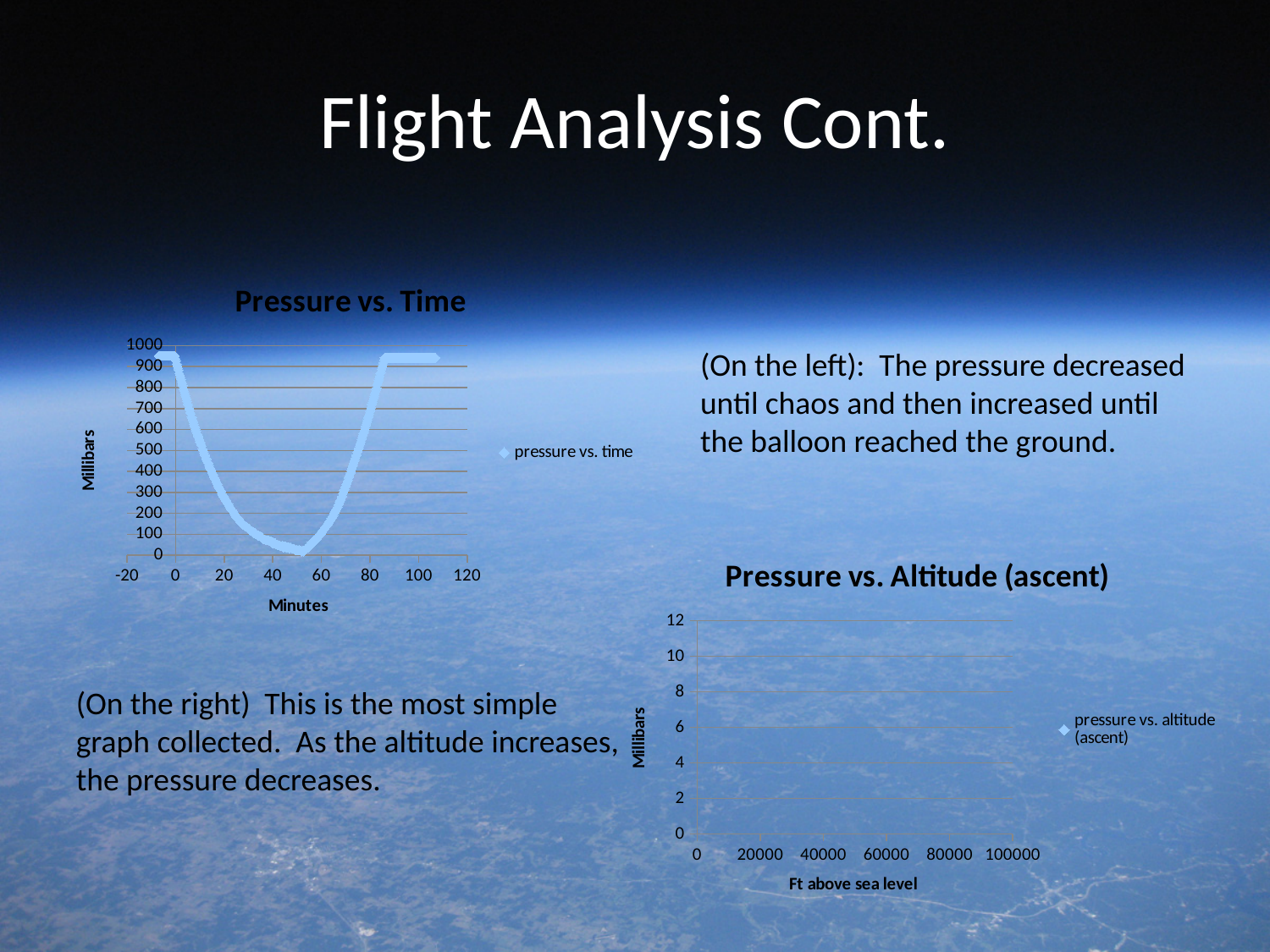
How many series does the legend of the "Pressure vs. Time" chart list? 1 In the "Pressure vs. Time" chart, is the pressure at 60 minutes greater or less than 300? less In the "Pressure vs. Time" chart, is the pressure at 80 minutes greater or less than 600? greater In the "Pressure vs. Time" chart, is the pressure higher at 20 minutes or at 90 minutes? 90 minutes What kind of chart is the "Pressure vs. Time" chart? scatter chart In the "Pressure vs. Time" chart, is the pressure at 100 minutes greater or less than 900? greater What is the x-axis title of the "Pressure vs. Altitude (ascent)" chart? Ft above sea level In the "Pressure vs. Time" chart, how does the pressure change between 0 and 50 minutes? it falls How many series does the legend of the "Pressure vs. Altitude (ascent)" chart list? 1 What is the x-axis title of the "Pressure vs. Time" chart? Minutes In the "Pressure vs. Time" chart, how does the pressure change between 60 and 90 minutes? it rises